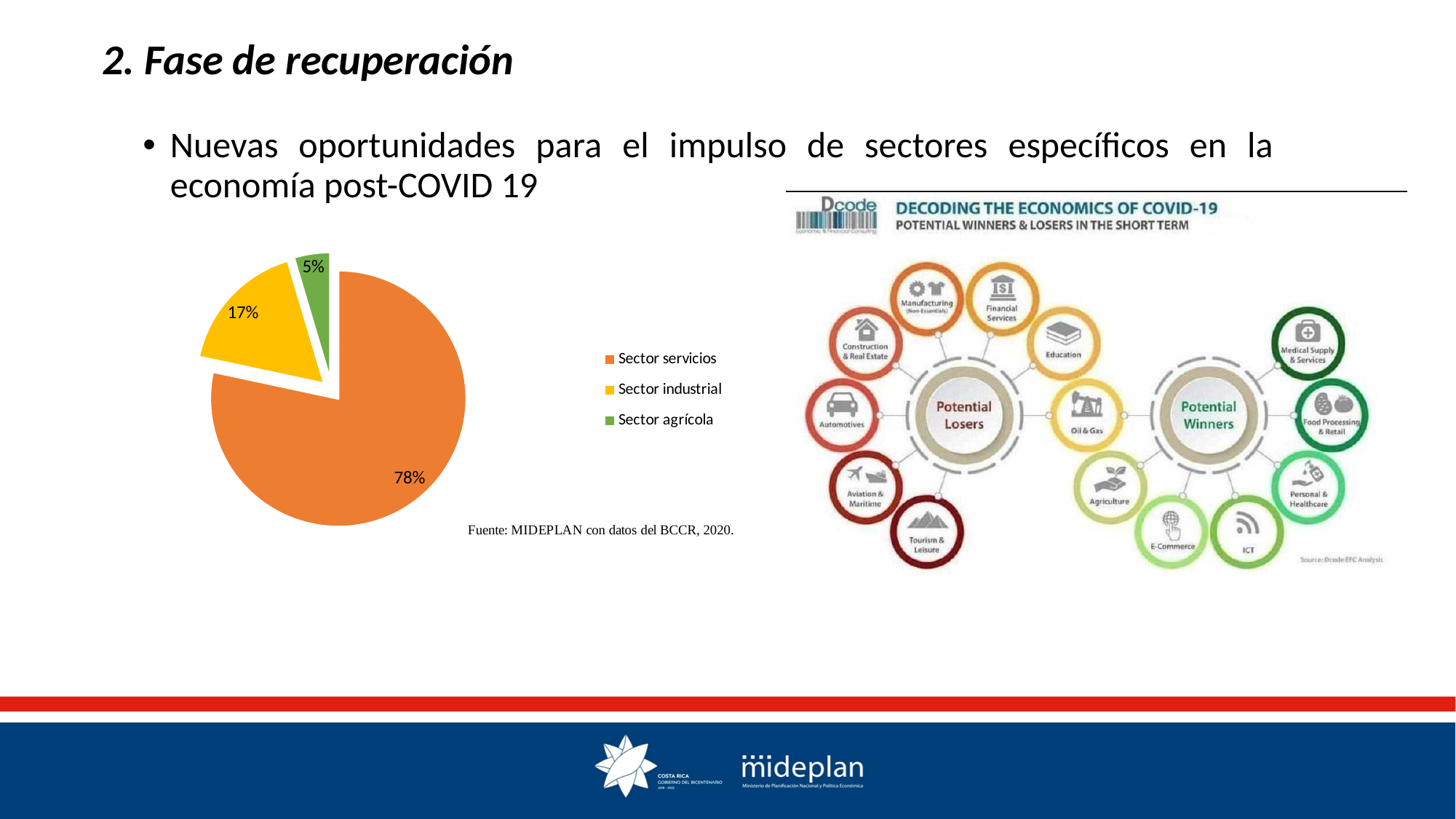
Which sector has the largest slice in the pie chart? Sector servicios What is the difference in percentage points between Sector industrial and Sector agrícola in the pie chart? 12 What type of chart is shown on the left of the slide? Pie chart What share of the pie chart does Sector servicios represent? 78% What colour is the Sector agrícola slice in the pie chart? Green Which is larger in the pie chart, Sector industrial or Sector agrícola? Sector industrial What is the difference in percentage points between Sector servicios and Sector industrial in the pie chart? 61 What source is cited below the pie chart? MIDEPLAN con datos del BCCR, 2020 How many slices does the pie chart have? 3 Which sector has the smallest slice in the pie chart? Sector agrícola What share of the pie chart does Sector industrial represent? 17% What share of the pie chart does Sector agrícola represent? 5%